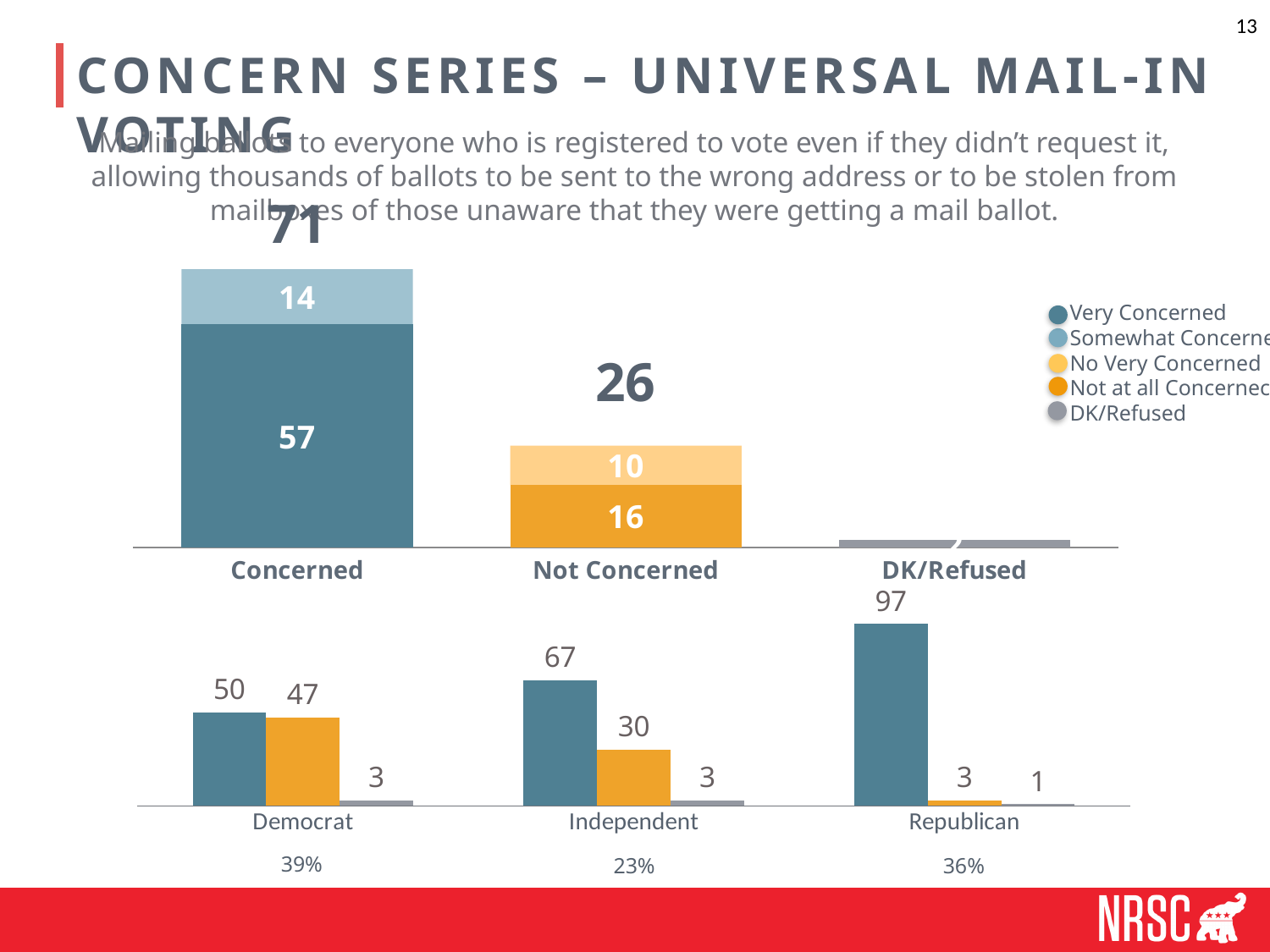
In the top chart, what is the difference between the Concerned total and the Not Concerned total? 45 How many entries does the legend on the slide list? 5 In the top chart, what is the Not at all Concerned value within the Not Concerned bar? 16 In the top chart, which category has the highest total? Concerned In the bottom chart, what is the value of the orange bar for Independent? 30 What type of chart is the bottom chart? bar chart In the bottom chart, which party has the lowest dark blue bar? Democrat In the top chart, what is the total for the Concerned bar? 71 In the bottom chart, what is the value of the first (dark blue) bar for Republican? 97 In the bottom chart, is the dark blue bar for Democrat larger or smaller than the orange bar for Democrat? larger In the top chart, what is the Very Concerned value within the Concerned bar? 57 In the bottom chart, how many party categories are shown on the x axis? 3